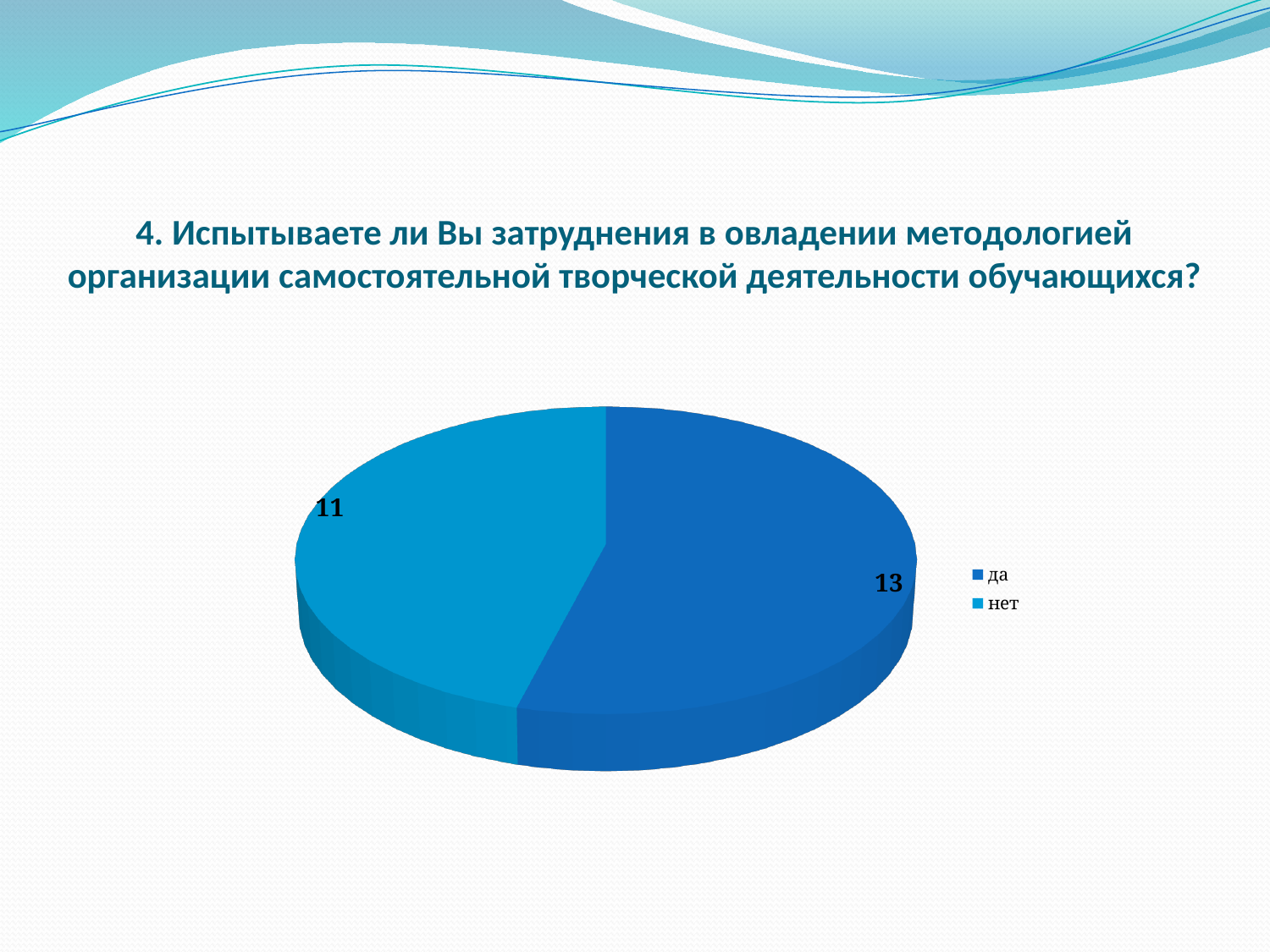
How many categories does the pie chart have? 2 How many entries does the legend list? 2 Which is larger, the value for "да" or the value for "нет"? да Where is the legend positioned relative to the pie? to the right What is the value for "нет"? 11 What kind of chart is shown on the slide? pie chart What is the value for "да"? 13 What is the total of all slices in the pie chart? 24 Which category has the smallest slice? нет Which legend entry is shown in the lighter blue colour? нет What is the difference between the values for "да" and "нет"? 2 Which category has the largest slice? да